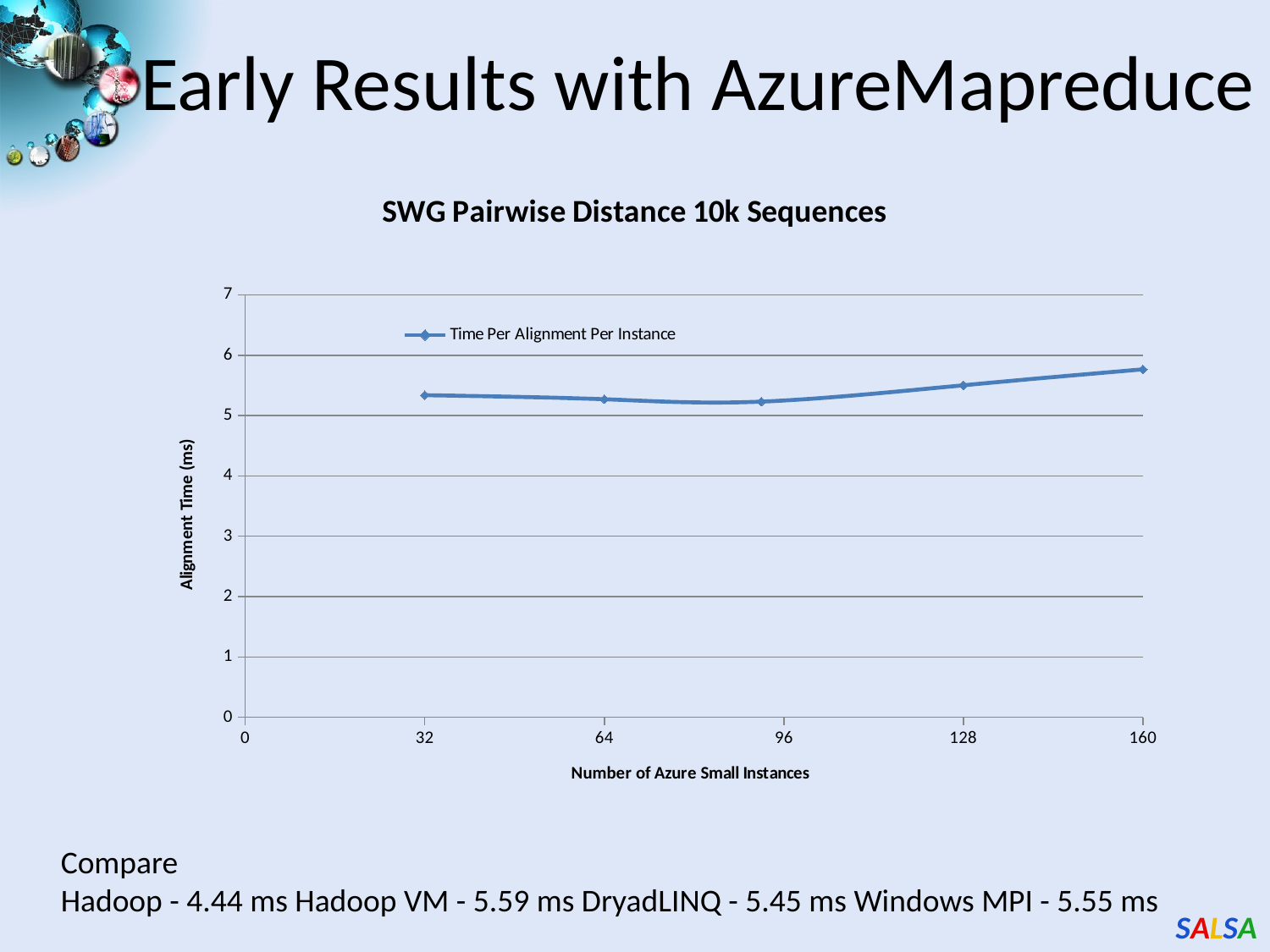
At which number of Azure small instances is the alignment time highest? 160 What kind of chart is shown on the slide? line chart Is the value for 128 Azure small instances greater or less than 6? less How many data points are plotted on the line? 5 What is the name of the series shown in the legend? Time Per Alignment Per Instance Does the alignment time rise or fall between 96 and 160 Azure small instances? rise Is the value for 160 Azure small instances greater or less than 6? less Is the value for 32 Azure small instances greater or less than 5? greater What is the title of the chart? SWG Pairwise Distance 10k Sequences Which has a higher alignment time: 128 instances or 64 instances? 128 instances Which has a higher alignment time: 160 instances or 32 instances? 160 instances How many series does the chart legend list? 1